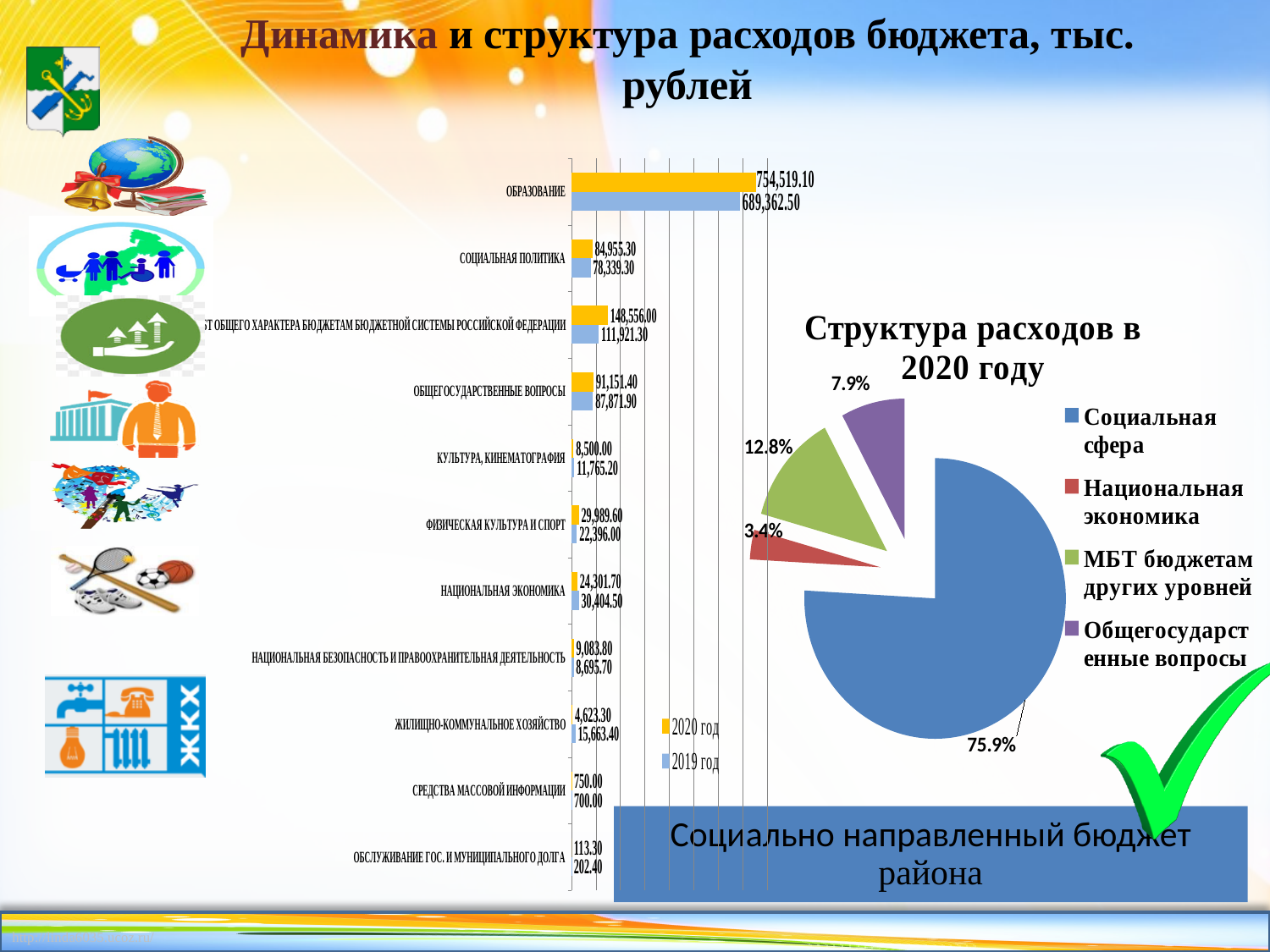
In the bar chart on the left, which category has the lowest value in 2019 год? Обслуживание гос. и муниципального долга In the pie chart 'Структура расходов в 2020 году', what colour is the slice for МБТ бюджетам других уровней? Green What kind of chart is the chart on the left of the slide? Bar chart How many series does the legend of the bar chart on the left list? 2 In the bar chart on the left, what is the value for Образование in 2020 год? 754,519.10 In the pie chart 'Структура расходов в 2020 году', what share does Социальная сфера have? 75.9% In the bar chart on the left, what is the difference between the 2020 год and 2019 год values for Социальная политика? 6,616.00 In the bar chart on the left, which is larger for Национальная экономика: the 2020 год value or the 2019 год value? 2019 год In the bar chart on the left, what is the value for Жилищно-коммунальное хозяйство in 2019 год? 15,663.40 In the bar chart on the left, which category has the highest value in 2020 год? Образование How many categories are shown in the bar chart on the left? 11 In the pie chart 'Структура расходов в 2020 году', which category has the smallest share? Национальная экономика